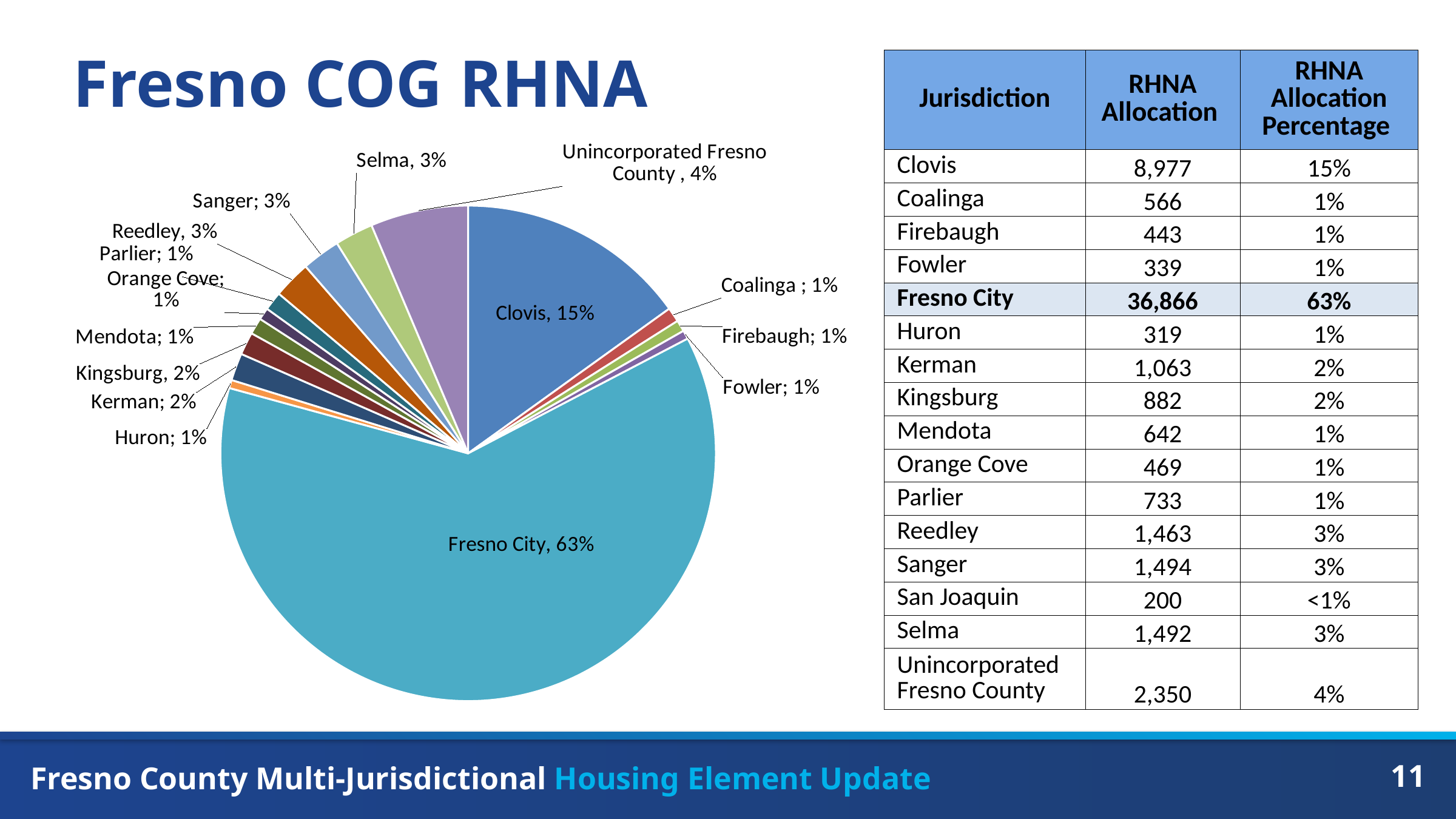
What percentage is shown for Kerman in the pie chart? 2% Which slice is larger in the pie chart, Clovis or Unincorporated Fresno County? Clovis What kind of chart is shown on the slide? pie chart By how many percentage points does Fresno City's share exceed Clovis's share in the pie chart? 48 percentage points Which jurisdiction has the largest slice of the pie chart? Fresno City What percentage is shown for Clovis in the pie chart? 15% What percentage is shown for Unincorporated Fresno County in the pie chart? 4% What percentage is shown for Selma in the pie chart? 3% Which slice is larger in the pie chart, Kingsburg or Reedley? Reedley What percentage is shown for Huron in the pie chart? 1% What share of the pie does Fresno City hold? 63% What is the title of the slide containing the pie chart? Fresno COG RHNA